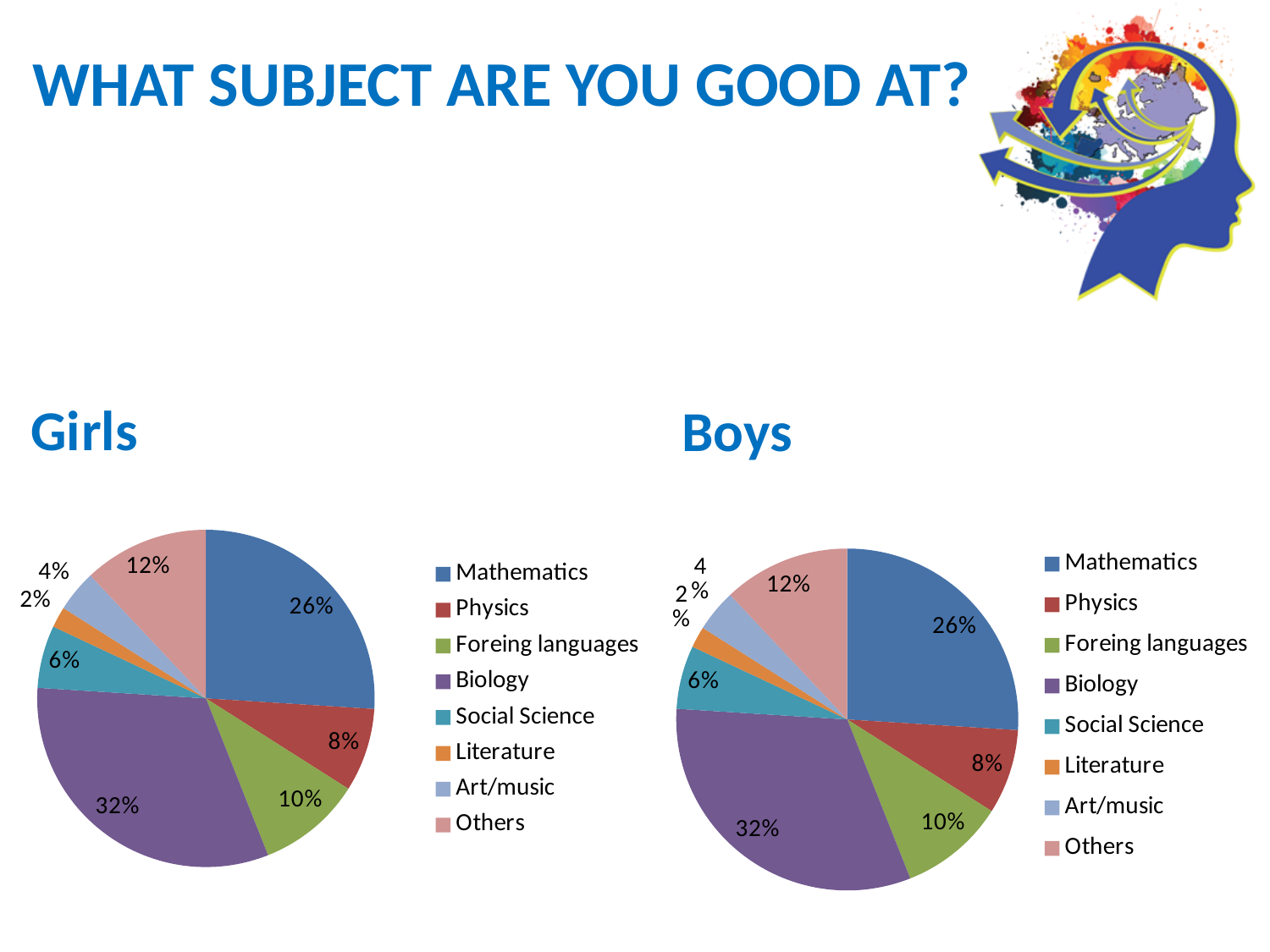
In the Girls chart, which subject has the largest slice? Biology How many slices does the Girls pie chart have? 8 In the Boys chart, what share does Mathematics have? 26% In the Girls chart, what share does Social Science have? 6% In the Girls chart, what share does Biology have? 32% In the Boys chart, which is larger: the Physics slice or the Foreing languages slice? Foreing languages In the Boys chart, what share does Others have? 12% In the Girls chart, what is the difference between the Biology share and the Mathematics share? 6% What type of chart is used for the Boys data? Pie chart In the Boys chart, which subject has the smallest slice? Literature In the Girls chart, what colour is the Biology slice? Purple In the Boys chart, what share does Literature have? 2%